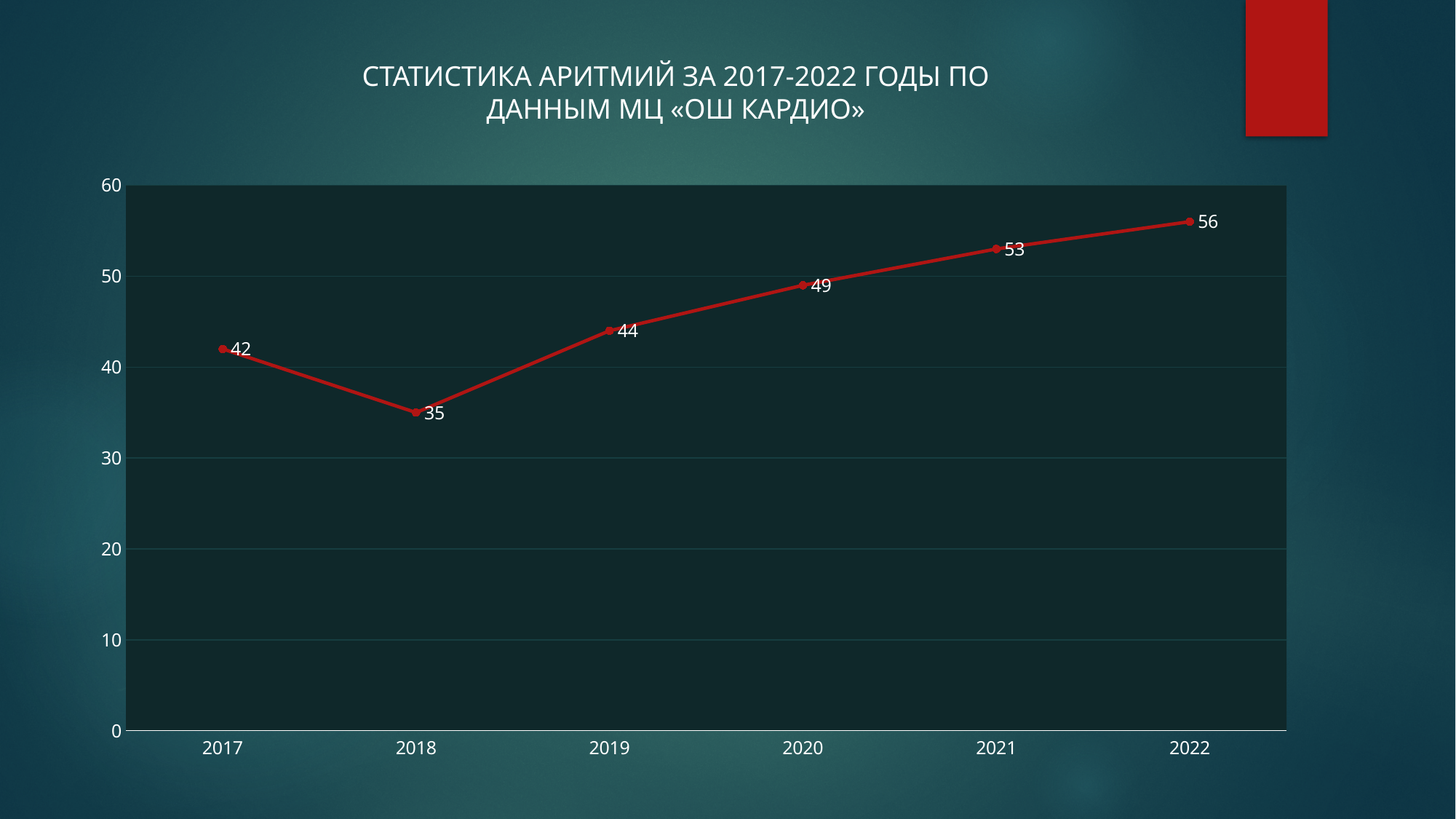
Which is larger, the value for 2017 or the value for 2019? 2019 Which year has the lowest value? 2018 Is the value for 2021 greater or less than 50? greater What is the difference between the values for 2019 and 2018? 9 What is the value for 2020? 49 What is the value for 2017? 42 What kind of chart is shown on the slide? line chart How many years are plotted on the chart? 6 What is the difference between the values for 2022 and 2017? 14 What is the value for 2022? 56 Which year has the highest value? 2022 What is the value for 2018? 35